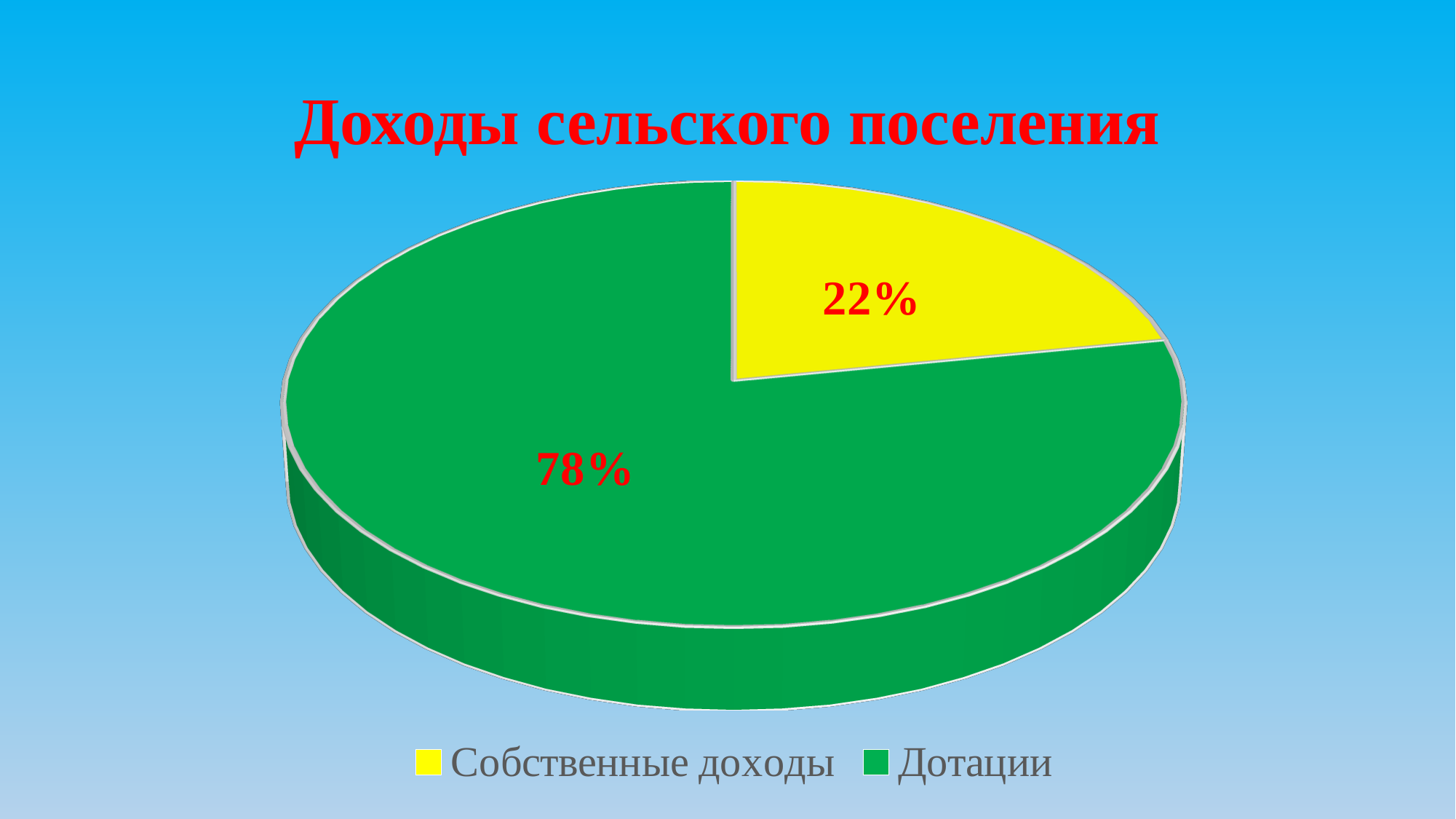
What kind of chart is shown on the slide? pie chart Which category has the largest slice of the pie? Дотации How many slices does the pie chart have? 2 What is the difference in percentage points between Дотации and Собственные доходы? 56 What is the title of the chart? Доходы сельского поселения What share of the pie does Дотации take? 78% What share of the pie does Собственные доходы take? 22% How many entries does the legend list? 2 What colour is the slice for Собственные доходы? yellow Which is larger, the slice for Собственные доходы or the slice for Дотации? Дотации What is the total of the two percentages shown on the pie? 100% Which category has the smallest slice of the pie? Собственные доходы